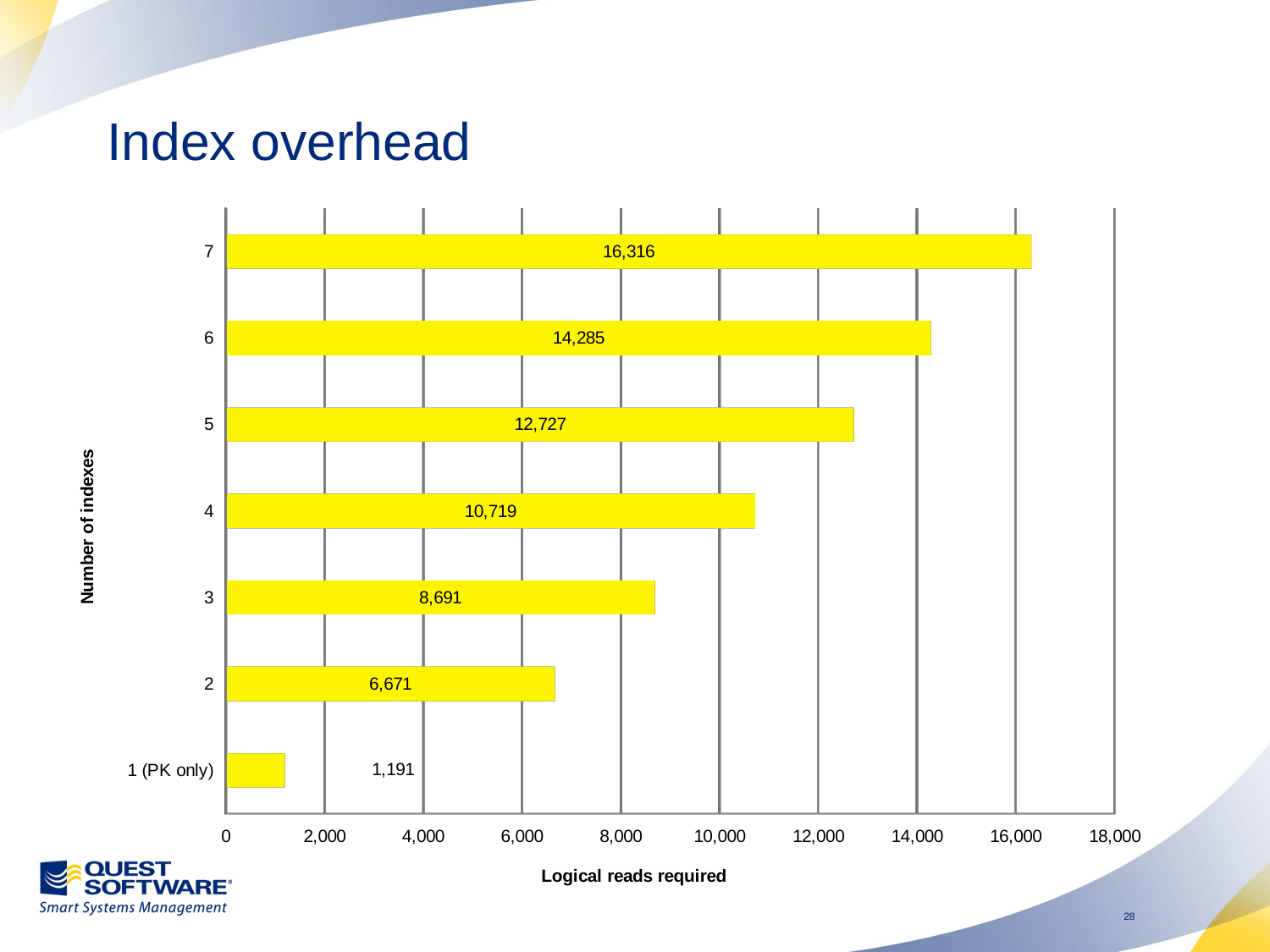
What is the number of logical reads required for 7 indexes? 16,316 Which number of indexes requires the most logical reads? 7 What is the label of the horizontal axis? Logical reads required What is the difference in logical reads between 7 indexes and 6 indexes? 2,031 How many categories (numbers of indexes) are shown on the chart? 7 What kind of chart is shown on the slide? Bar chart What is the difference in logical reads between 2 indexes and 1 (PK only)? 5,480 What is the number of logical reads required for 4 indexes? 10,719 Which number of indexes requires the fewest logical reads? 1 (PK only) What is the number of logical reads required for 1 (PK only) index? 1,191 Which requires more logical reads, 3 indexes or 5 indexes? 5 indexes Is the value for 6 indexes greater or less than 14,000? greater